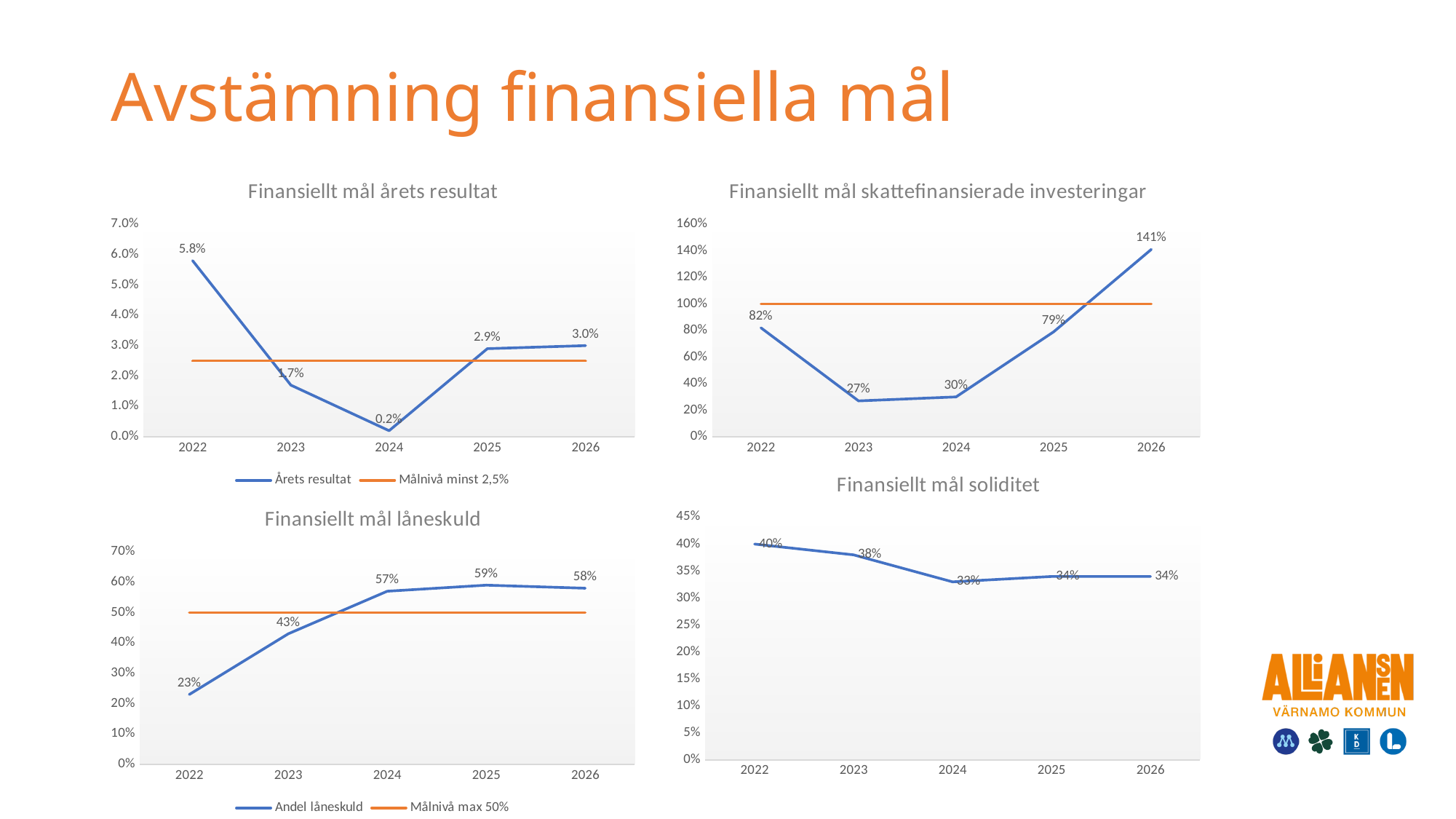
In the chart 'Finansiellt mål skattefinansierade investeringar', what is the value for 2026? 141% In the chart 'Finansiellt mål årets resultat', what is the value for 2022? 5.8% In the chart 'Finansiellt mål årets resultat', which year has the lowest value for Årets resultat? 2024 In the chart 'Finansiellt mål låneskuld', which is larger, the value for 2025 or the value for 2022? 2025 What kind of chart is 'Finansiellt mål soliditet'? line chart In the chart 'Finansiellt mål låneskuld', what is the name of the orange series in the legend? Målnivå max 50% In the chart 'Finansiellt mål låneskuld', what is the value for Andel låneskuld in 2023? 43% In the chart 'Finansiellt mål skattefinansierade investeringar', what is the difference between the 2022 value and the 2023 value? 55% In the chart 'Finansiellt mål skattefinansierade investeringar', which year has the highest value? 2026 In the chart 'Finansiellt mål soliditet', how many years are shown on the x axis? 5 In the chart 'Finansiellt mål soliditet', what is the value for 2024? 33% In the chart 'Finansiellt mål årets resultat', how many series does the legend list? 2